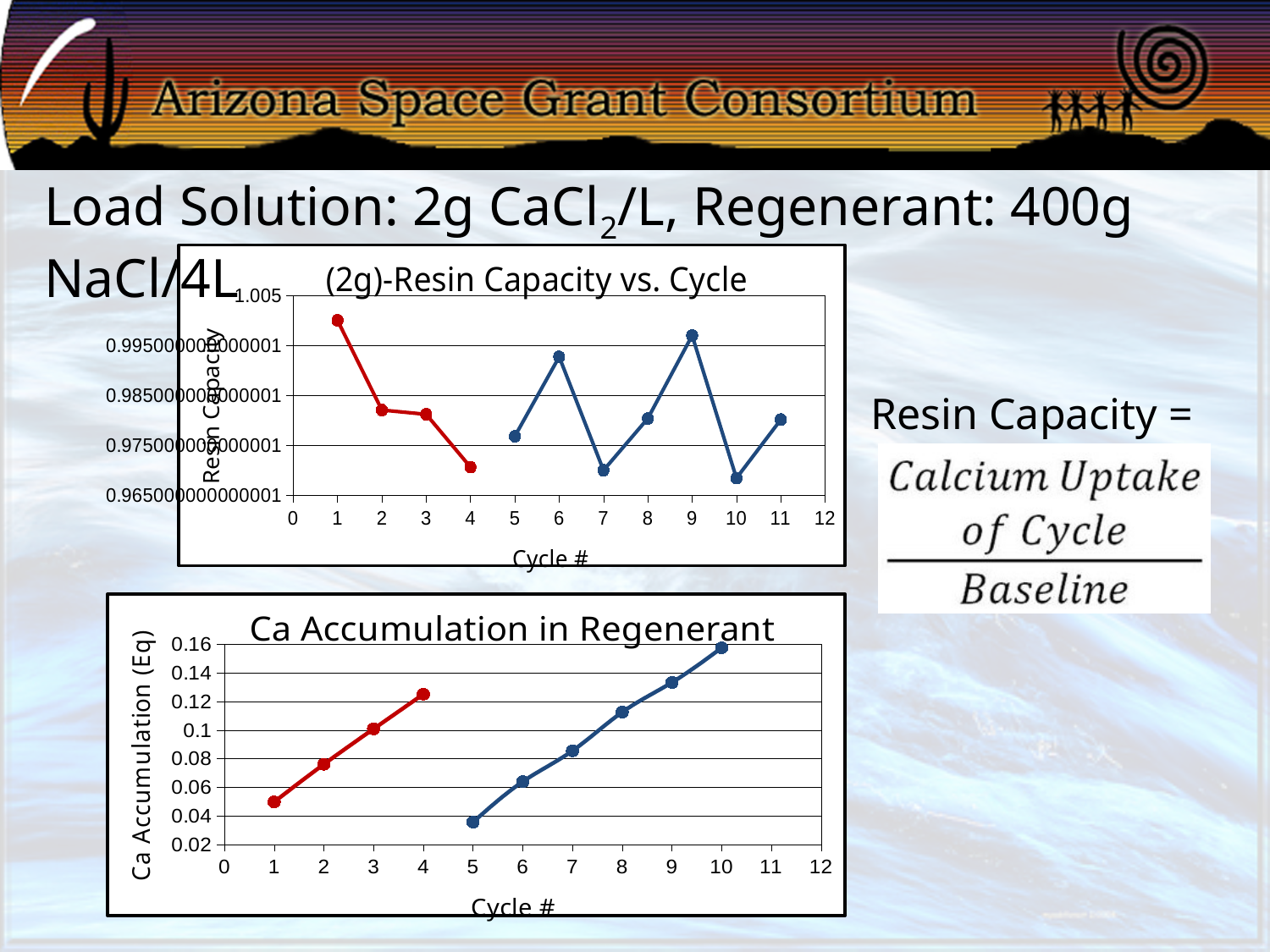
In the 'Ca Accumulation in Regenerant' chart, at which cycle number is the Ca accumulation lowest? 5 What kind of chart is the 'Ca Accumulation in Regenerant' chart? line chart In the 'Ca Accumulation in Regenerant' chart, is the value at cycle 5 greater or less than 0.04? less In the 'Ca Accumulation in Regenerant' chart, how many data points are plotted in total? 10 In the 'Ca Accumulation in Regenerant' chart, do the values of the blue series rise or fall as the cycle number increases? rise In the '(2g)-Resin Capacity vs. Cycle' chart, how many data points are plotted in total? 11 In the 'Ca Accumulation in Regenerant' chart, which is larger, the value at cycle 4 or the value at cycle 7? cycle 4 What is the x-axis label of the 'Ca Accumulation in Regenerant' chart? Cycle # In the '(2g)-Resin Capacity vs. Cycle' chart, at which cycle number is the resin capacity lowest? 10 What kind of chart is the '(2g)-Resin Capacity vs. Cycle' chart? line chart In the 'Ca Accumulation in Regenerant' chart, at which cycle number is the Ca accumulation highest? 10 In the 'Ca Accumulation in Regenerant' chart, is the value at cycle 10 greater or less than 0.14? greater